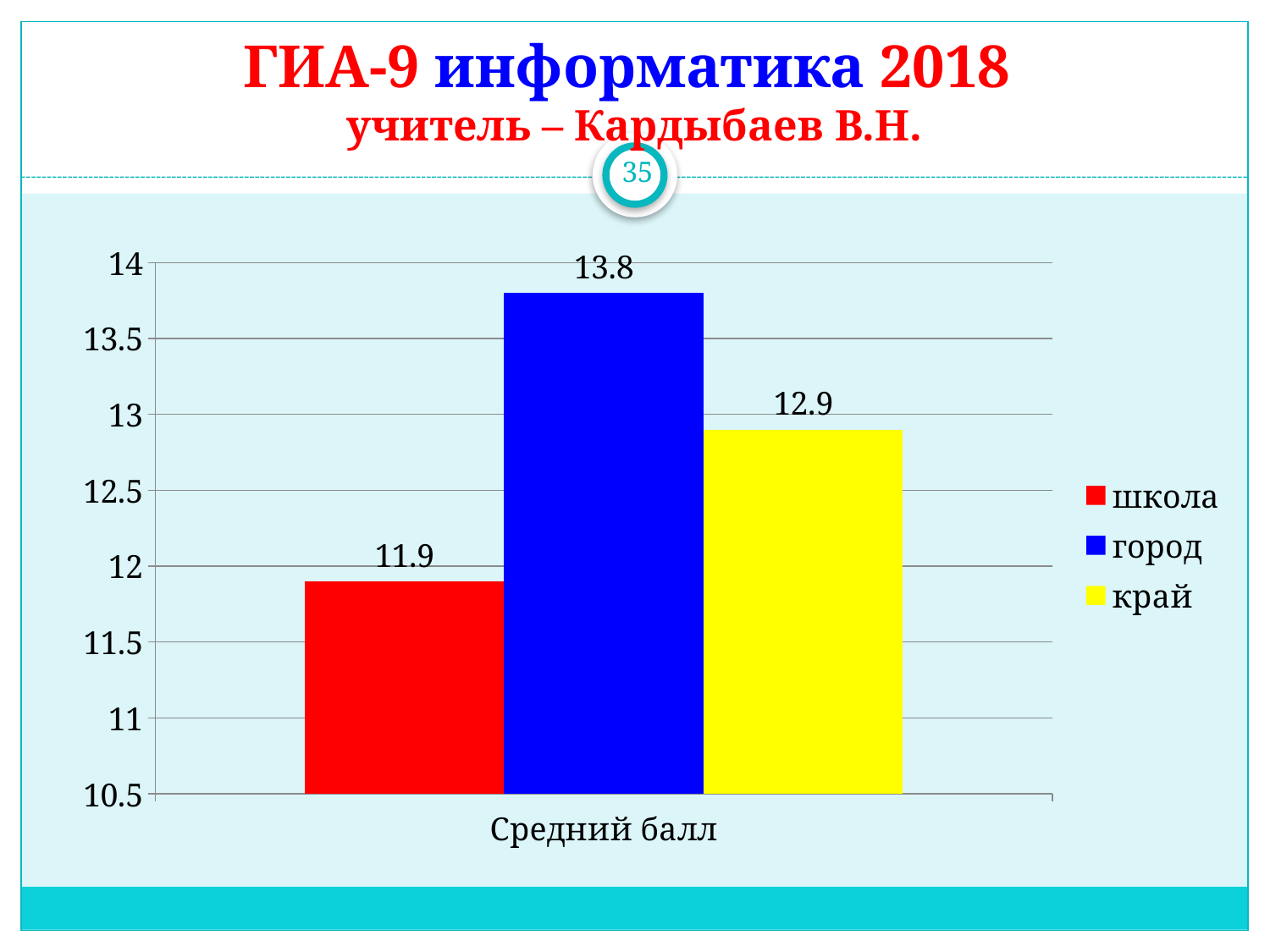
Which is larger, the value for город or the value for край? город Which series has the highest value in the chart? город What is the label on the x axis of the chart? Средний балл How many series does the legend list? 3 What is the difference between the values for город and школа? 1.9 What is the difference between the values for край and школа? 1 What is the value for город in the chart? 13.8 Is the value for школа greater or less than 12? less What is the value for школа in the chart? 11.9 What kind of chart is shown on the slide? bar chart Which series has the lowest value in the chart? школа What is the value for край in the chart? 12.9